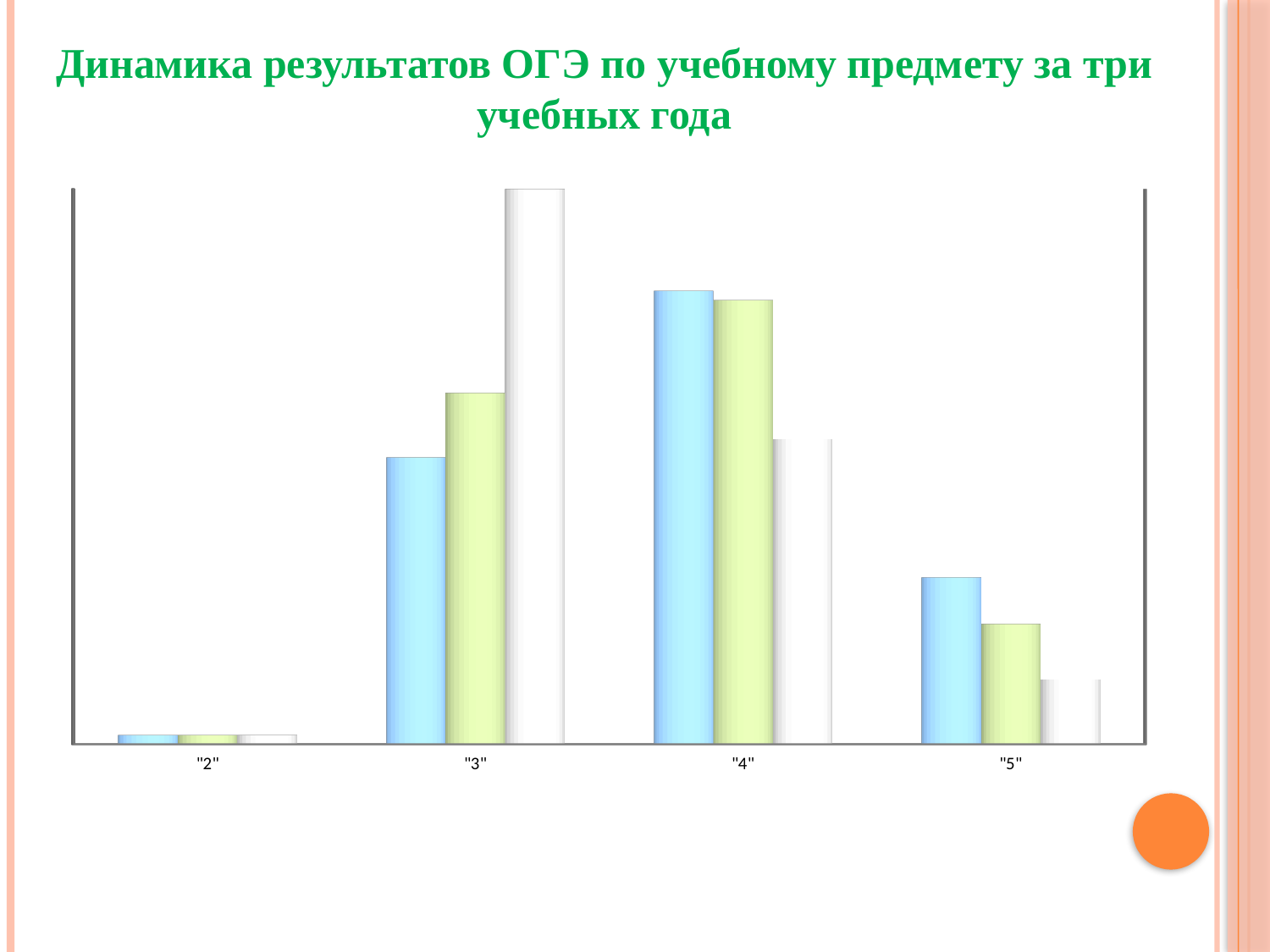
Which category has the tallest blue bar? "4" For category "5", which bar is taller: the blue bar or the green bar? blue For category "5", which bar is taller: the green bar or the white bar? green What is the title of the slide? Динамика результатов ОГЭ по учебному предмету за три учебных года Is the blue bar taller for category "3" or for category "4"? "4" How many bars are plotted for each category? 3 Which category has the shortest green bar? "2" How many categories are shown on the x axis? 4 Which category has the shortest blue bar? "2" Which category has the tallest white bar? "3" What kind of chart is shown on the slide? bar chart